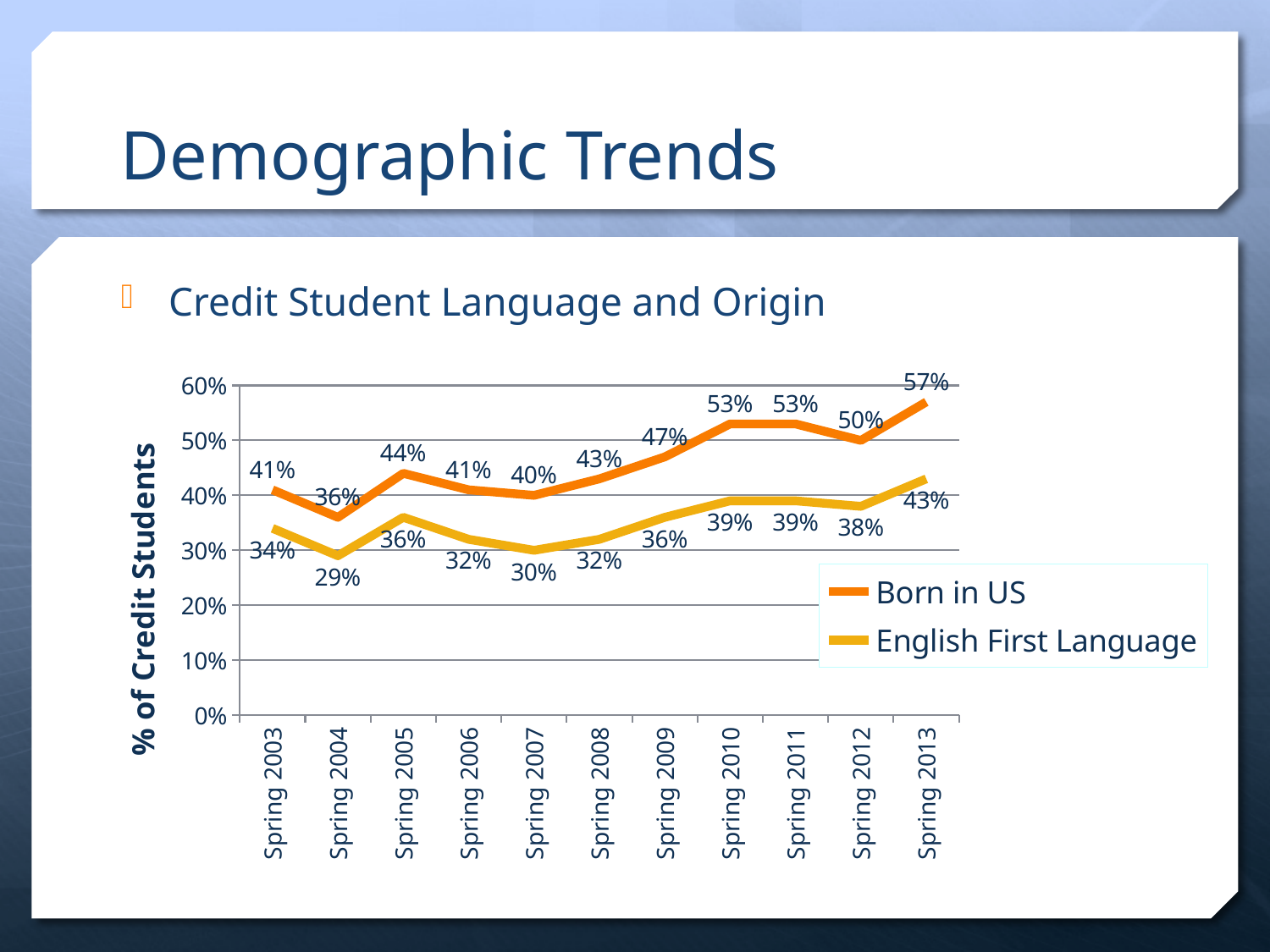
What is the label of the vertical axis? % of Credit Students Which is larger in Spring 2007: Born in US or English First Language? Born in US How many series does the legend list? 2 Does the Born in US series generally rise or fall from Spring 2007 to Spring 2013? Rise In which period is the English First Language value highest? Spring 2013 What is the value for English First Language in Spring 2004? 29% How many periods are shown on the x axis? 11 What type of chart is shown on the slide? Line chart What is the difference between Born in US and English First Language in Spring 2012? 12% What is the value for Born in US in Spring 2009? 47% In which period is the Born in US value lowest? Spring 2004 What is the value for Born in US in Spring 2013? 57%